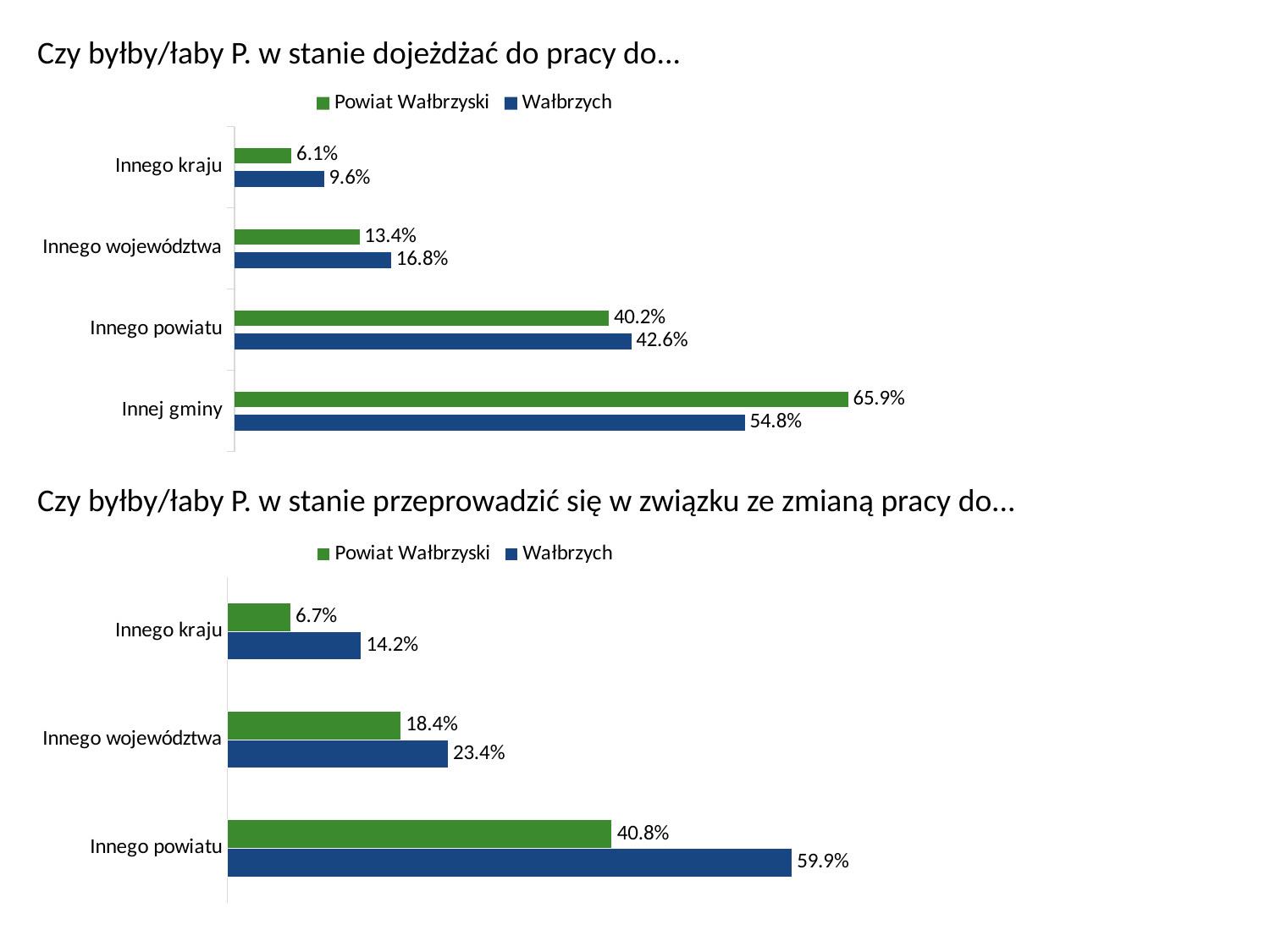
In the top chart (commuting to work), what is the difference between the Powiat Wałbrzyski and Wałbrzych values for 'Innej gminy'? 11.1% How many series does the legend of the top chart (commuting to work) list? 2 How many categories are shown in the bottom chart (relocating for work)? 3 In the top chart (commuting to work), what is the value for Powiat Wałbrzyski for 'Innej gminy'? 65.9% In the bottom chart (relocating for work), what is the difference between the Wałbrzych and Powiat Wałbrzyski values for 'Innego powiatu'? 19.1% In the bottom chart (relocating for work), which is larger for 'Innego kraju': Powiat Wałbrzyski or Wałbrzych? Wałbrzych In the bottom chart (relocating for work), what is the value for Powiat Wałbrzyski for 'Innego województwa'? 18.4% What type of chart is the top chart (commuting to work)? Bar chart In the top chart (commuting to work), which category has the lowest value for Wałbrzych? Innego kraju In the bottom chart (relocating for work), which category has the highest value for Powiat Wałbrzyski? Innego powiatu In the top chart (commuting to work), what is the value for Wałbrzych for 'Innego kraju'? 9.6% In the bottom chart (relocating for work), what is the value for Wałbrzych for 'Innego powiatu'? 59.9%